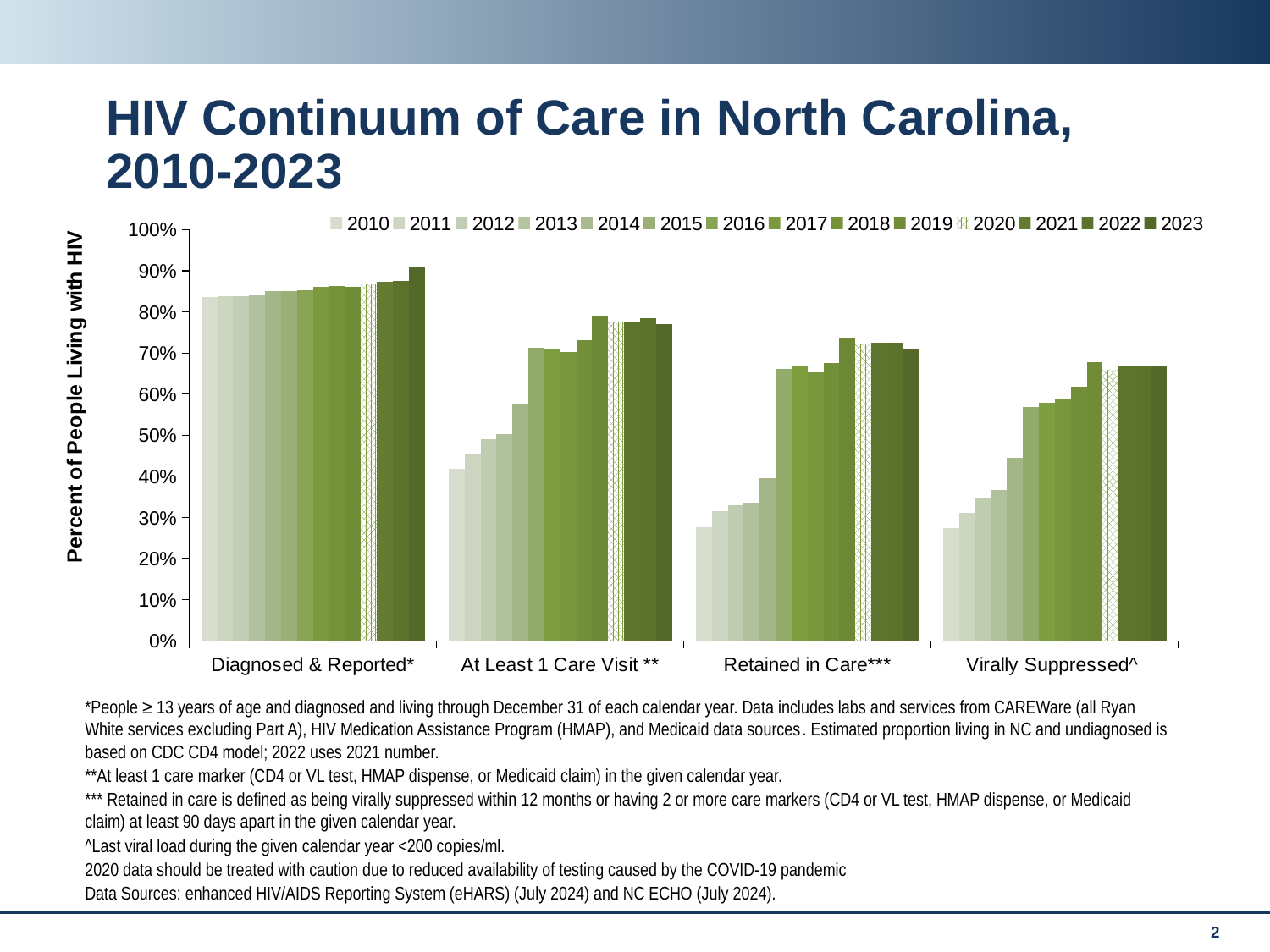
What kind of chart is shown on the slide? Bar chart Is the value for Retained in Care in 2023 greater or less than 60%? greater Which category has the highest value in 2010? Diagnosed & Reported What is the title of the y axis? Percent of People Living with HIV Is the value for Diagnosed & Reported in 2010 greater or less than 80%? greater Which category has the lowest value in 2023? Virally Suppressed How many years (series) does the legend list? 14 Do the Virally Suppressed values rise or fall from 2010 to 2023? rise Which is larger in 2023: Diagnosed & Reported or Virally Suppressed? Diagnosed & Reported Is the value for Virally Suppressed in 2010 greater or less than 30%? less How many categories are shown along the x axis? 4